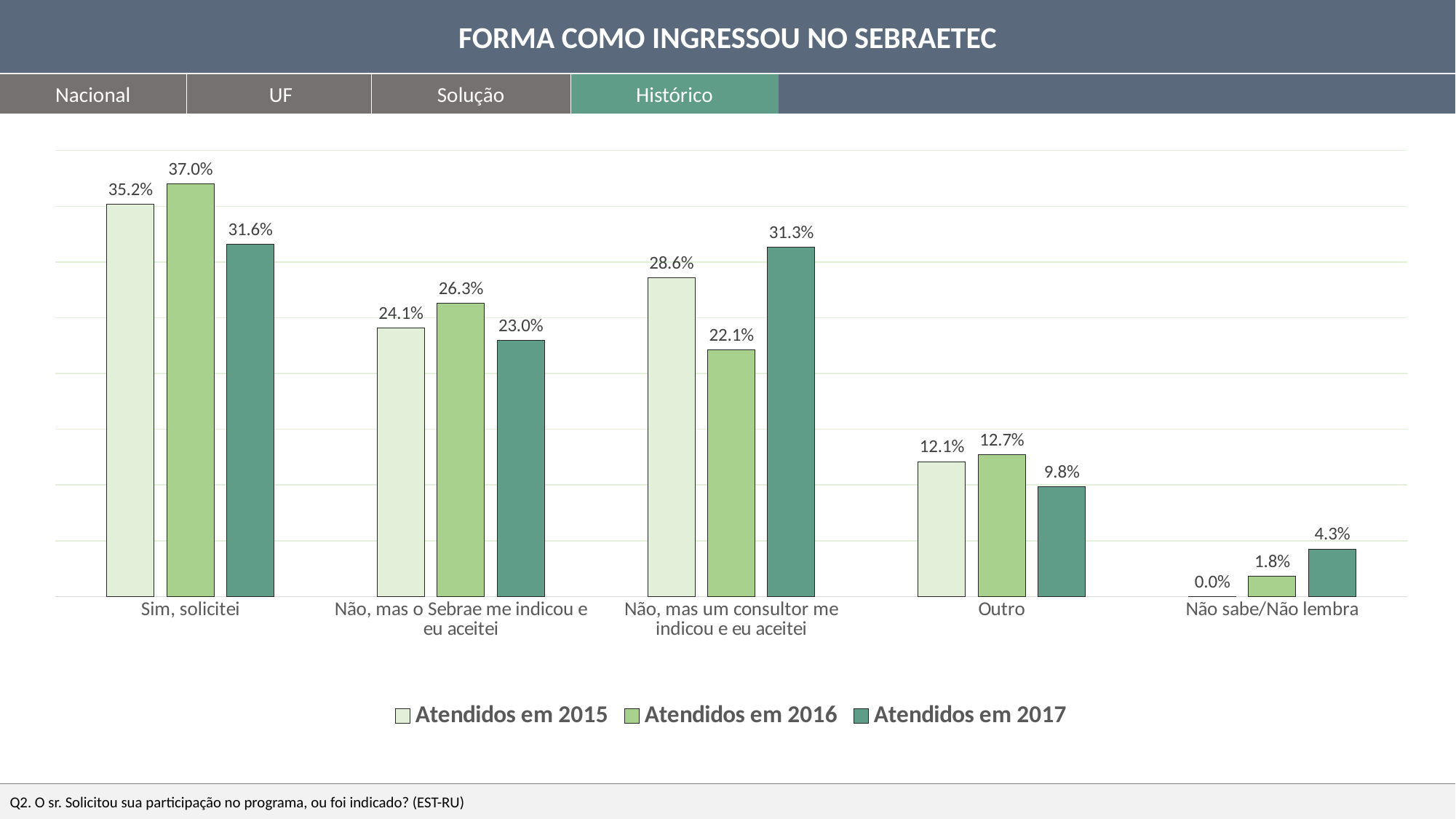
For "Não, mas o Sebrae me indicou e eu aceitei", which series has the larger value: Atendidos em 2015 or Atendidos em 2017? Atendidos em 2015 What is the difference between the Atendidos em 2017 and Atendidos em 2016 values for "Não, mas um consultor me indicou e eu aceitei"? 9.2% Which category has the lowest value in the Atendidos em 2016 series? Não sabe/Não lembra Do the values for "Não sabe/Não lembra" rise or fall from Atendidos em 2015 to Atendidos em 2017? Rise What is the value for "Sim, solicitei" in the Atendidos em 2016 series? 37.0% What is the value for "Não sabe/Não lembra" in the Atendidos em 2015 series? 0.0% What kind of chart is shown on the slide? Bar chart Which category has the highest value in the Atendidos em 2017 series? Sim, solicitei How many categories are shown on the x axis? 5 What is the value for "Outro" in the Atendidos em 2017 series? 9.8% How many series does the legend list? 3 What is the title of the chart? FORMA COMO INGRESSOU NO SEBRAETEC